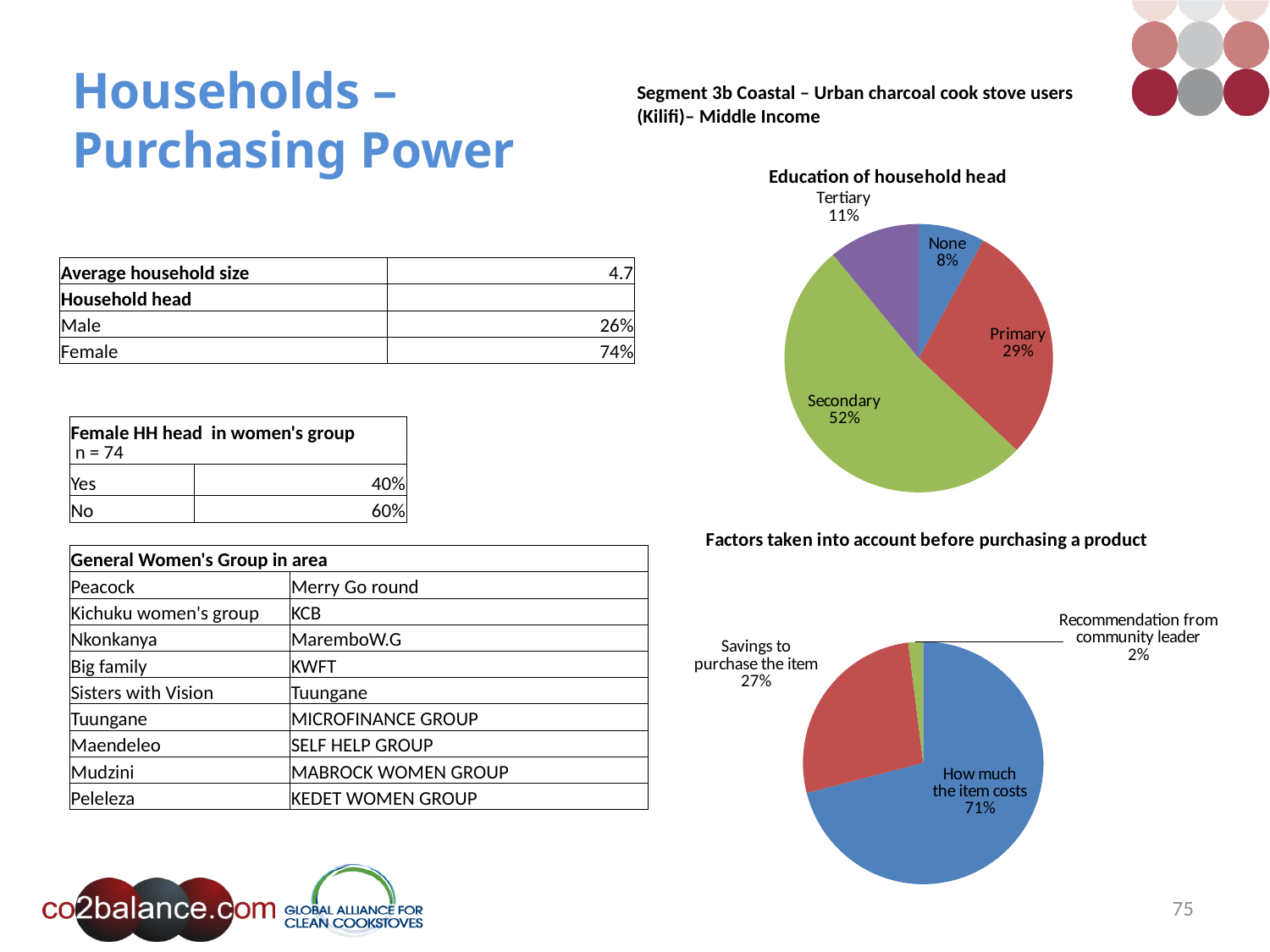
In the 'Factors taken into account before purchasing a product' chart, what share is 'Recommendation from community leader'? 2% In the 'Education of household head' chart, how many categories are shown? 4 In the 'Factors taken into account before purchasing a product' chart, how many factors are shown? 3 In the 'Education of household head' chart, what is the difference between the Primary and Tertiary shares? 18% In the 'Education of household head' chart, what share of household heads have secondary education? 52% In the 'Education of household head' chart, which education level has the smallest share? None What type of chart is 'Education of household head'? Pie chart In the 'Education of household head' chart, which education level has the largest share? Secondary In the 'Factors taken into account before purchasing a product' chart, which is larger: 'Savings to purchase the item' or 'Recommendation from community leader'? Savings to purchase the item In the 'Education of household head' chart, what percentage of household heads have no education? 8% In the 'Factors taken into account before purchasing a product' chart, which factor has the largest share? How much the item costs In the 'Factors taken into account before purchasing a product' chart, what share is 'How much the item costs'? 71%